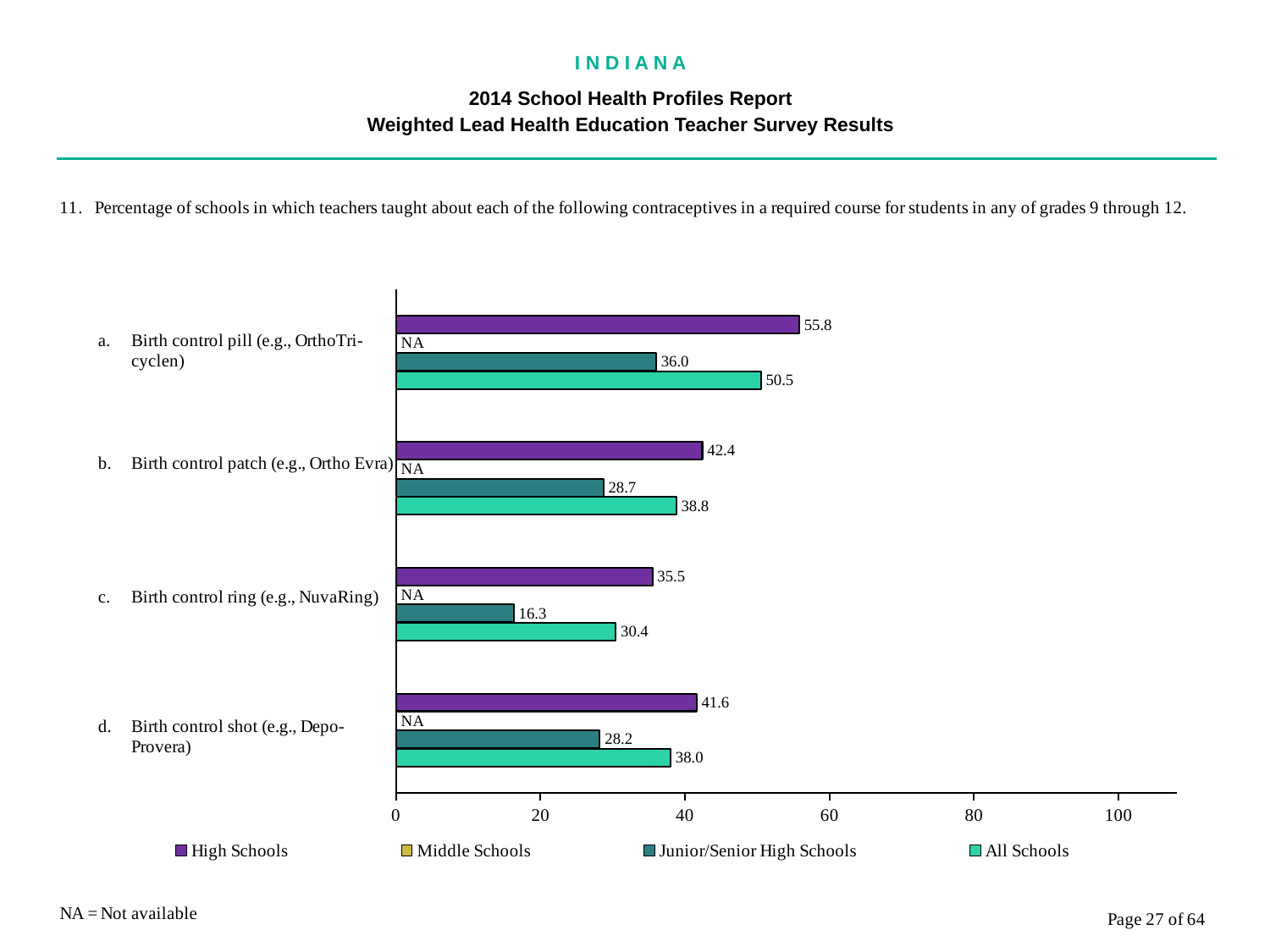
Which contraceptive has the lowest All Schools value? Birth control ring (e.g., NuvaRing) How many contraceptive categories are shown on the chart? 4 What is the value for High Schools for Birth control pill (e.g., OrthoTri-cyclen)? 55.8 How many series does the legend list? 4 What is the difference between the High Schools and Junior/Senior High Schools values for Birth control patch (e.g., Ortho Evra)? 13.7 Is the All Schools value for Birth control pill (e.g., OrthoTri-cyclen) greater or less than 40? greater What is shown for Middle Schools for Birth control patch (e.g., Ortho Evra)? NA Which contraceptive has the highest High Schools value? Birth control pill (e.g., OrthoTri-cyclen) What is the value for Junior/Senior High Schools for Birth control ring (e.g., NuvaRing)? 16.3 Which is larger for Birth control shot (e.g., Depo-Provera): the High Schools value or the All Schools value? High Schools What is the value for All Schools for Birth control shot (e.g., Depo-Provera)? 38.0 What kind of chart is shown on the slide? Bar chart